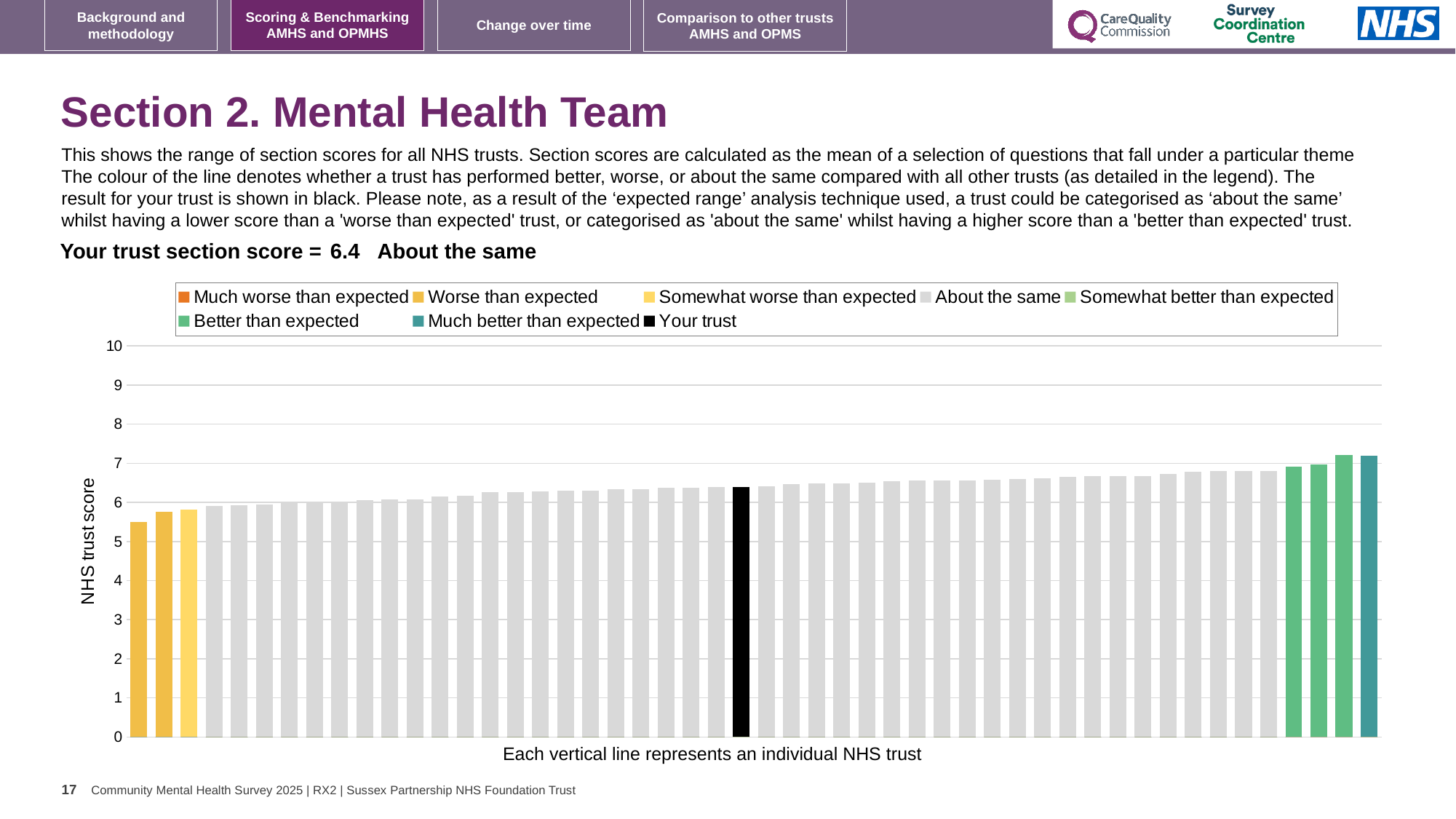
What kind of chart is shown on the slide? bar chart What is the section score for your trust shown on the slide? 6.4 What is the label on the vertical axis of the chart? NHS trust score Is the value of the lowest bar on the chart greater or less than 6? less How many entries does the chart legend list? 8 What colour is the bar representing your trust? black Do the bar values rise or fall from left to right along the x axis? rise Which category is your trust placed in for this section score? About the same Is the value of the highest bar on the chart greater or less than 8? less Is the value for your trust (the black bar) greater or less than 6? greater